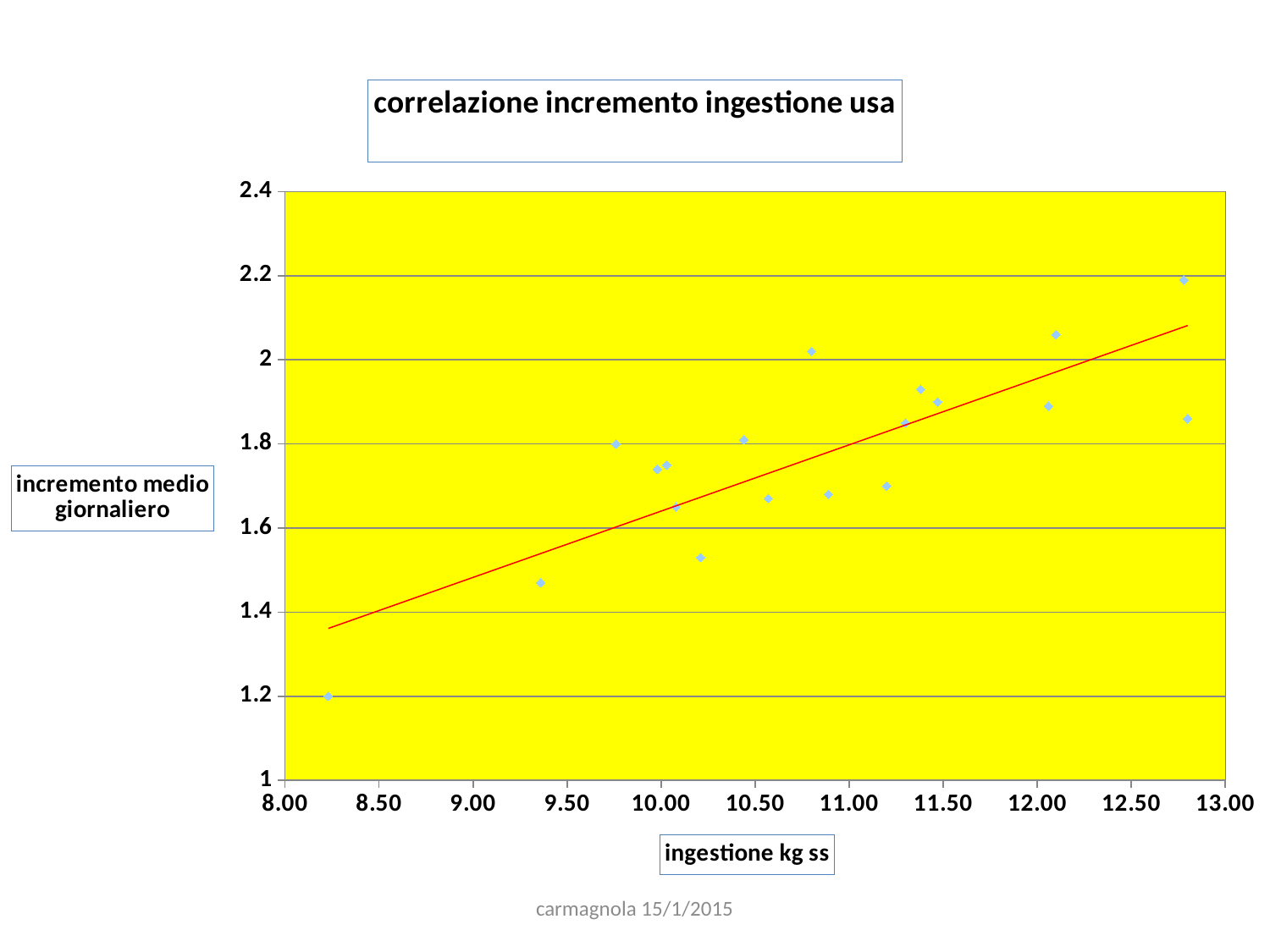
What kind of chart is shown on the slide? scatter chart Do the plotted values generally rise or fall as ingestione kg ss increases along the x axis? rise Is the incremento medio giornaliero value for the point near 9.36 kg ss greater or less than 1.6? less What is the title of the chart? correlazione incremento ingestione usa Is the incremento medio giornaliero value for the leftmost point (near 8.25 kg ss) greater or less than 1.4? less What is the label of the x axis? ingestione kg ss Is the incremento medio giornaliero value for the point near 10.8 kg ss greater or less than 1.8? greater What is the maximum value shown on the x axis? 13.00 Which point has the lowest incremento medio giornaliero: the one near 8.25 kg ss or the one near 12.8 kg ss? the one near 8.25 kg ss